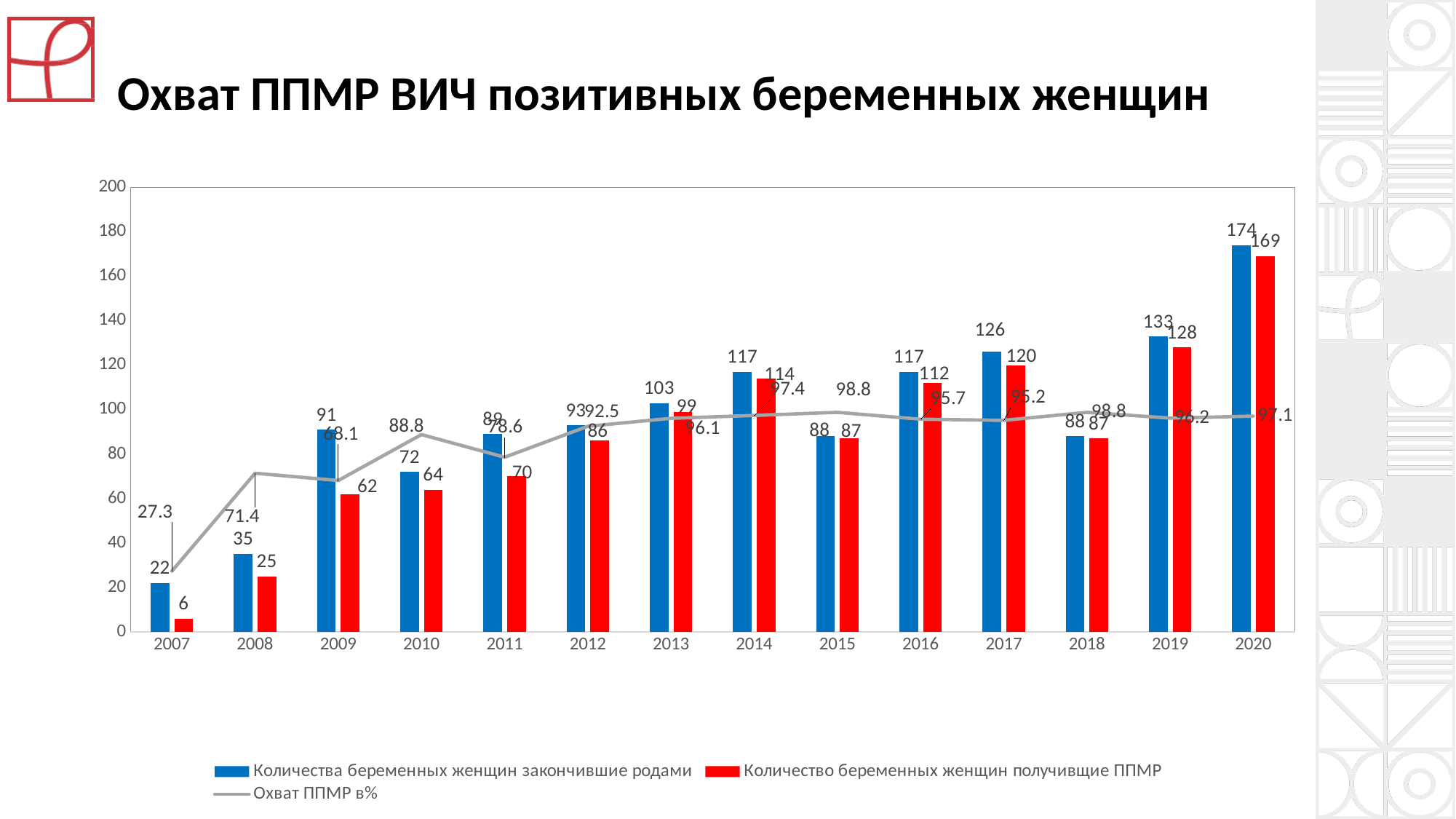
What kind of chart is shown on the slide? Combined bar and line chart How many pregnant women completed childbirth (blue series) in 2020? 174 What is the difference between the blue bar and the red bar in 2009? 29 What is the PMTCT coverage percentage (Охват ППМР в%) for 2007? 27.3 In which year is the number of pregnant women who completed childbirth (blue series) the highest? 2020 How many series does the legend list? 3 How many pregnant women received PMTCT (red series) in 2013? 99 In which year is the number of pregnant women who received PMTCT (red series) the lowest? 2007 How many years are shown on the x axis? 14 What is the title of the chart on the slide? Охват ППМР ВИЧ позитивных беременных женщин Which is larger in 2010: the number who completed childbirth (blue) or the number who received PMTCT (red)? Number who completed childbirth (blue), 72 Does the PMTCT coverage percentage (grey line) rise or fall from 2007 to 2008? Rise